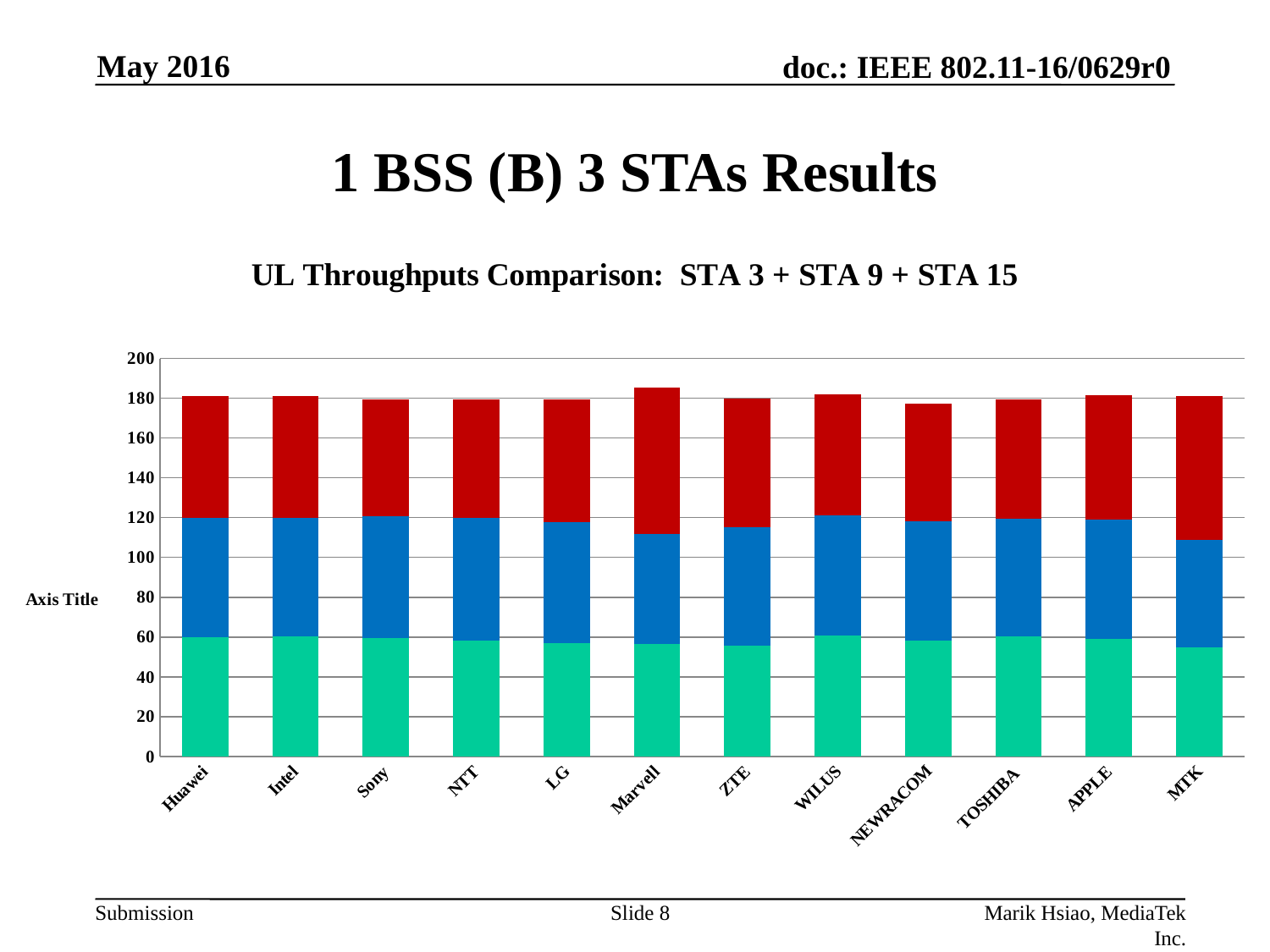
Is the top of the middle (blue) segment for Marvell greater or less than 120? less Which has the larger bottom (green) segment, WILUS or MTK? WILUS What kind of chart is shown on the slide? stacked bar chart Is the total stacked value for NEWRACOM greater or less than 180? less How many categories (companies) are shown on the x axis? 12 Which has the taller stacked bar, Marvell or NEWRACOM? Marvell What is the title of the chart? UL Throughputs Comparison: STA 3 + STA 9 + STA 15 Which category has the tallest stacked bar? Marvell How many stacked segments make up each bar? 3 What is the label shown on the vertical axis? Axis Title Is the total stacked value for Marvell greater or less than 180? greater